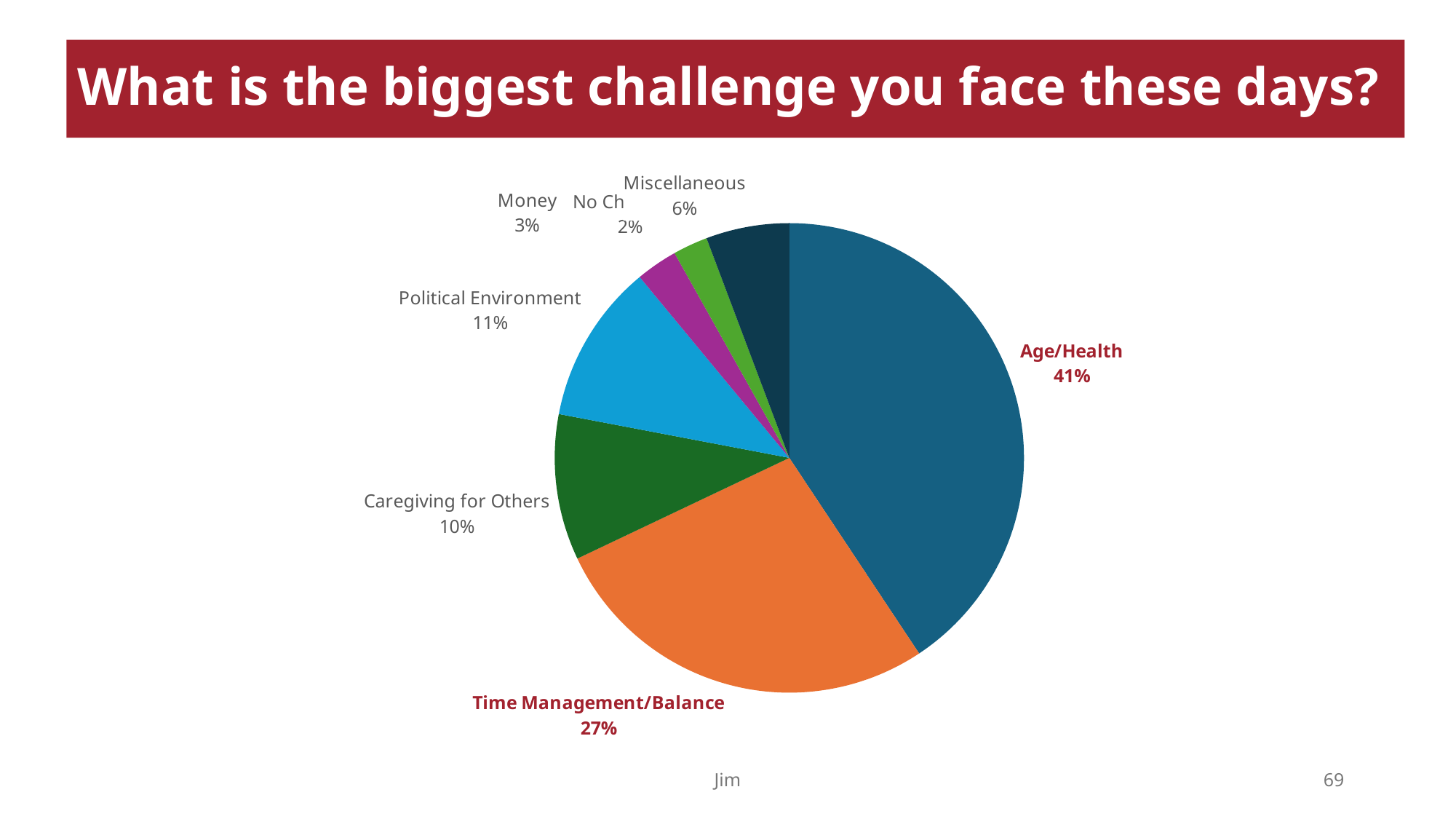
Which is larger, the share for Political Environment or the share for Caregiving for Others? Political Environment Which category has the smallest slice of the pie? No Ch How many categories are shown in the pie chart? 7 What kind of chart is shown on the slide? Pie chart What share of the pie does Age/Health represent? 41% What is the value shown for Political Environment? 11% Which category has the largest slice of the pie? Age/Health What is the value shown for Time Management/Balance? 27% What is the title of the slide containing the chart? What is the biggest challenge you face these days? What is the value shown for Caregiving for Others? 10% What is the value shown for Miscellaneous? 6% What is the difference between the Age/Health and Time Management/Balance shares? 14%